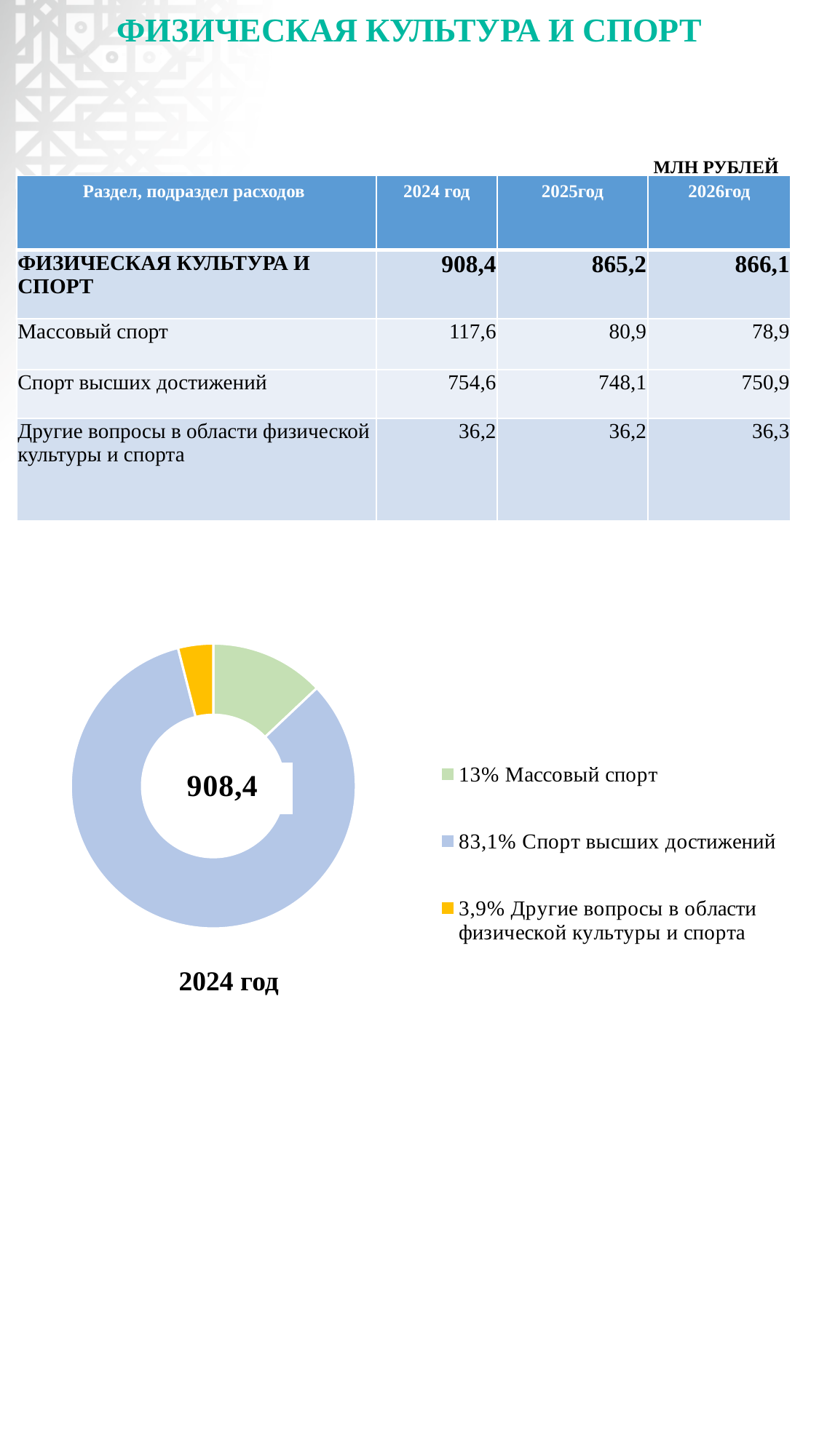
What total value is shown in the centre of the doughnut chart? 908,4 What kind of chart is shown on the slide? doughnut (pie) chart Which slice is larger in the doughnut chart: Массовый спорт or Другие вопросы в области физической культуры и спорта? Массовый спорт What colour is the Спорт высших достижений slice in the doughnut chart? light blue What is the difference in percentage points between the Спорт высших достижений slice and the Массовый спорт slice? 70,1 Which category has the smallest slice in the doughnut chart? Другие вопросы в области физической культуры и спорта What share of the doughnut chart does Спорт высших достижений represent? 83,1% Which year does the doughnut chart represent, according to the label below it? 2024 год Which category has the largest slice in the doughnut chart? Спорт высших достижений What share of the doughnut chart does Другие вопросы в области физической культуры и спорта represent? 3,9% How many slices does the doughnut chart have? 3 What share of the doughnut chart does Массовый спорт represent? 13%